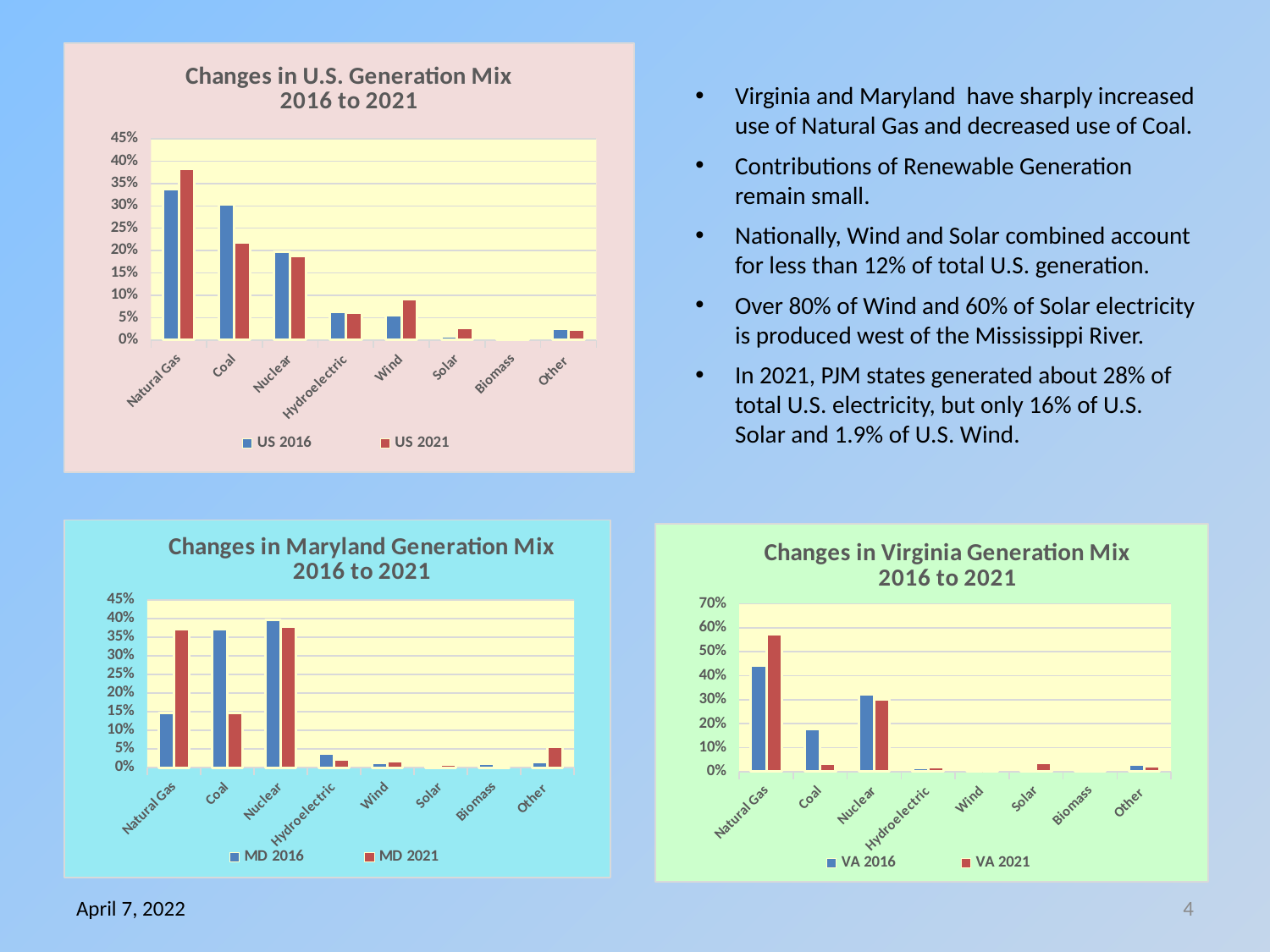
In the 'Changes in U.S. Generation Mix 2016 to 2021' chart, what kind of chart is shown? Bar chart In the 'Changes in U.S. Generation Mix 2016 to 2021' chart, which category has the highest US 2021 value? Natural Gas In the 'Changes in U.S. Generation Mix 2016 to 2021' chart, how many categories are shown on the x axis? 8 In the 'Changes in Virginia Generation Mix 2016 to 2021' chart, what are the two legend entries? VA 2016 and VA 2021 In the 'Changes in U.S. Generation Mix 2016 to 2021' chart, is the US 2016 value for Coal greater or less than 25%? greater In the 'Changes in Maryland Generation Mix 2016 to 2021' chart, is the MD 2021 value for Natural Gas greater or less than 30%? greater In the 'Changes in Maryland Generation Mix 2016 to 2021' chart, which is larger for Natural Gas, MD 2016 or MD 2021? MD 2021 In the 'Changes in U.S. Generation Mix 2016 to 2021' chart, which is larger for Coal, US 2016 or US 2021? US 2016 In the 'Changes in Virginia Generation Mix 2016 to 2021' chart, which category has the highest VA 2021 value? Natural Gas In the 'Changes in Maryland Generation Mix 2016 to 2021' chart, is the MD 2021 value for Coal greater or less than 20%? less In the 'Changes in U.S. Generation Mix 2016 to 2021' chart, how many series does the legend list? 2